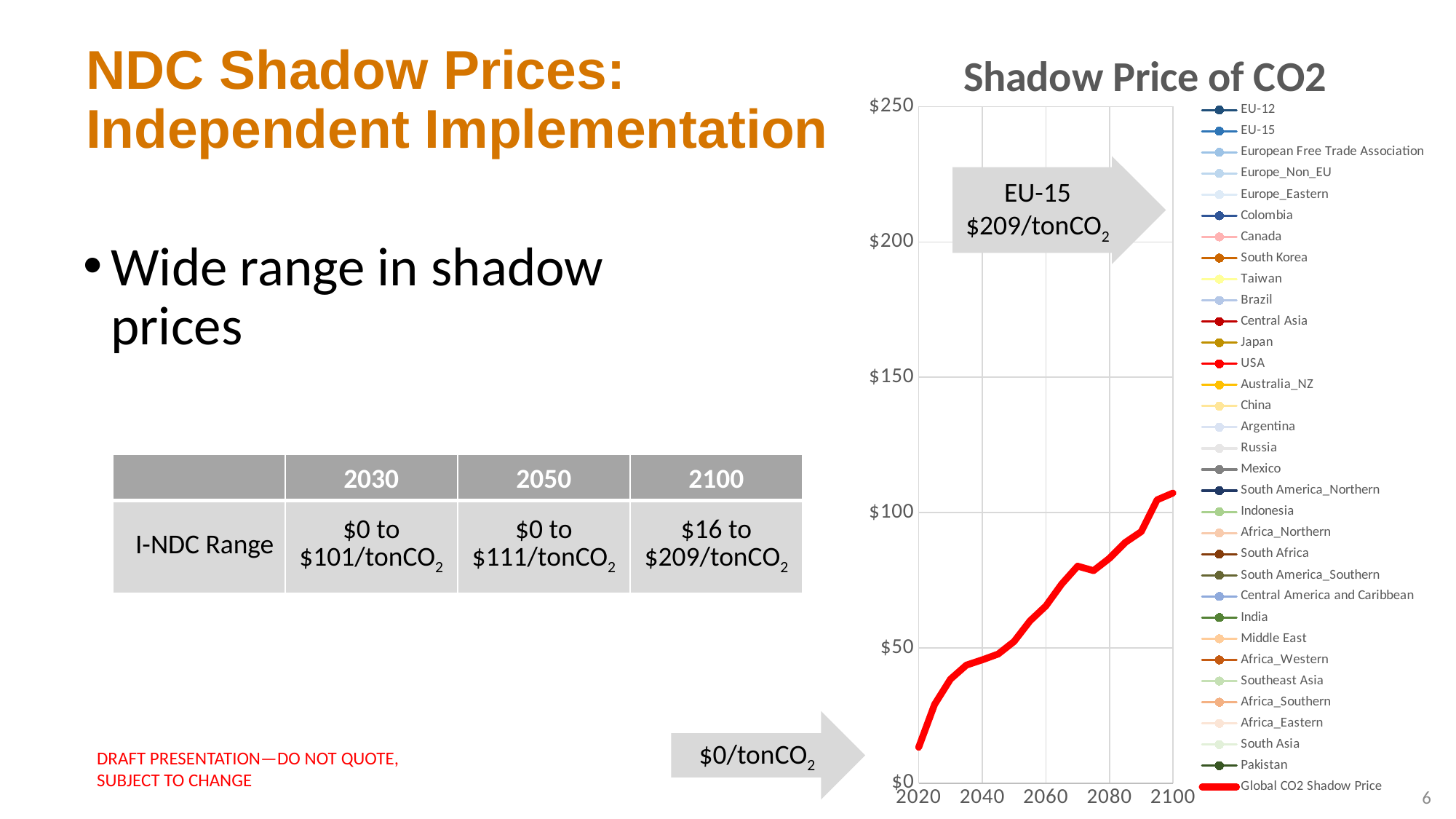
In the 'Shadow Price of CO2' chart, is the Global CO2 Shadow Price higher in 2100 or in 2020? 2100 What is the title of the chart on the right of the slide? Shadow Price of CO2 What kind of chart is the 'Shadow Price of CO2' chart? line chart In the 'Shadow Price of CO2' chart, which series is drawn as the thick red line? Global CO2 Shadow Price In the 'Shadow Price of CO2' chart, does the Global CO2 Shadow Price rise or fall from 2020 to 2100? rise In the 'Shadow Price of CO2' chart, what value does the arrow annotation give for EU-15? $209/tonCO2 In the 'Shadow Price of CO2' chart, is the Global CO2 Shadow Price in 2060 greater or less than $50? greater In the 'Shadow Price of CO2' chart, is the Global CO2 Shadow Price in 2080 greater or less than $100? less How many series does the legend of the 'Shadow Price of CO2' chart list? 33 In the 'Shadow Price of CO2' chart, is the Global CO2 Shadow Price in 2100 greater or less than $150? less